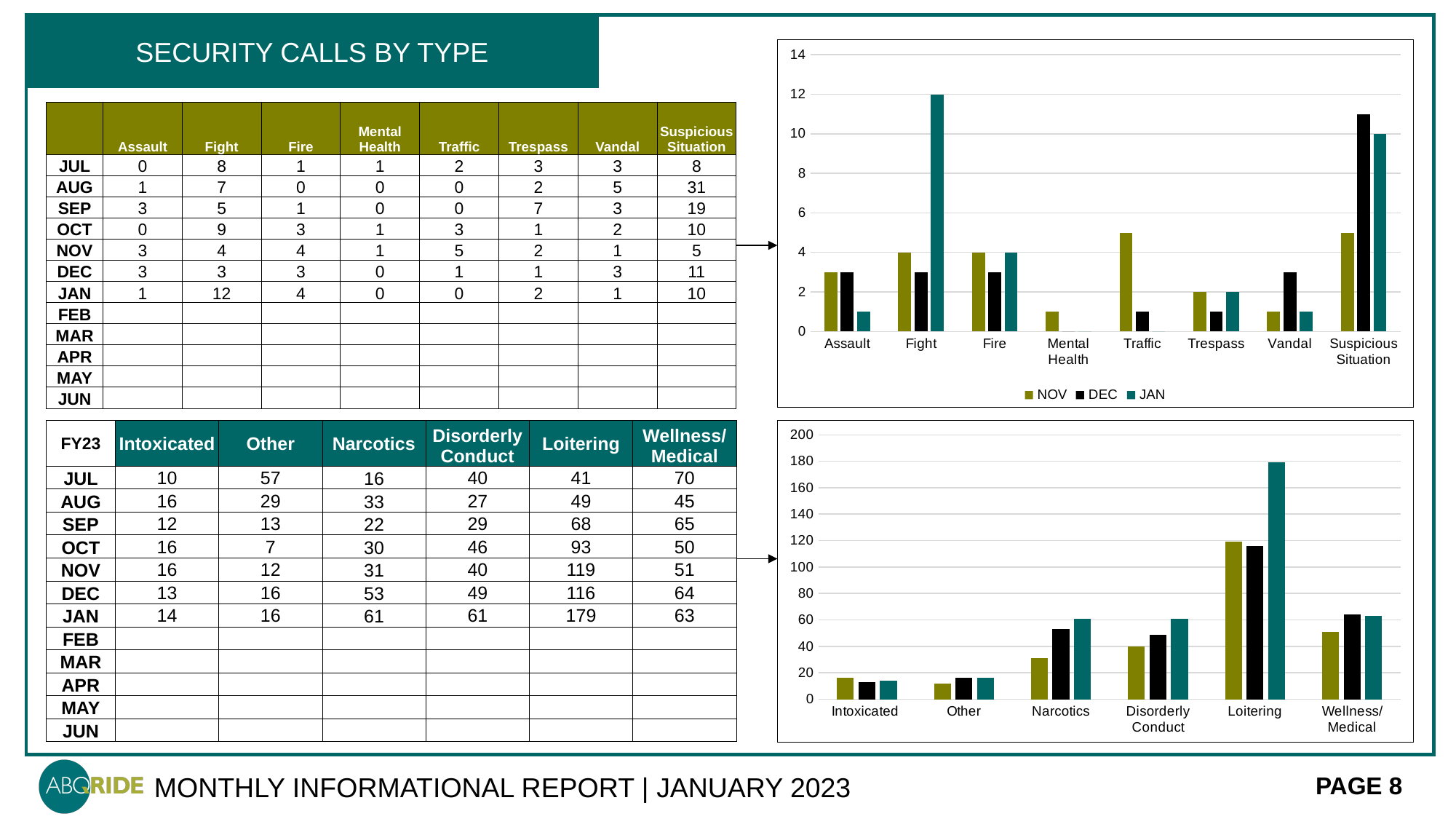
In the bottom chart, is the first (NOV) bar for Intoxicated greater or less than 20? less In the top chart, is the DEC value for Suspicious Situation greater or less than 10? greater In the top chart, how many series does the legend list? 3 In the bottom chart, is the tallest Loitering bar greater or less than 160? greater In the top chart, what is the JAN value for Fight? 12 In the top chart, which category has the tallest bar overall? Fight In the top chart, how many categories are shown on the x axis? 8 In the top chart, which is larger for Traffic: the NOV bar or the DEC bar? NOV In the bottom chart, how many categories are shown on the x axis? 6 In the top chart, what type of chart is shown? bar chart In the top chart, what is the JAN value for Suspicious Situation? 10 In the bottom chart, which category has the tallest bar? Loitering